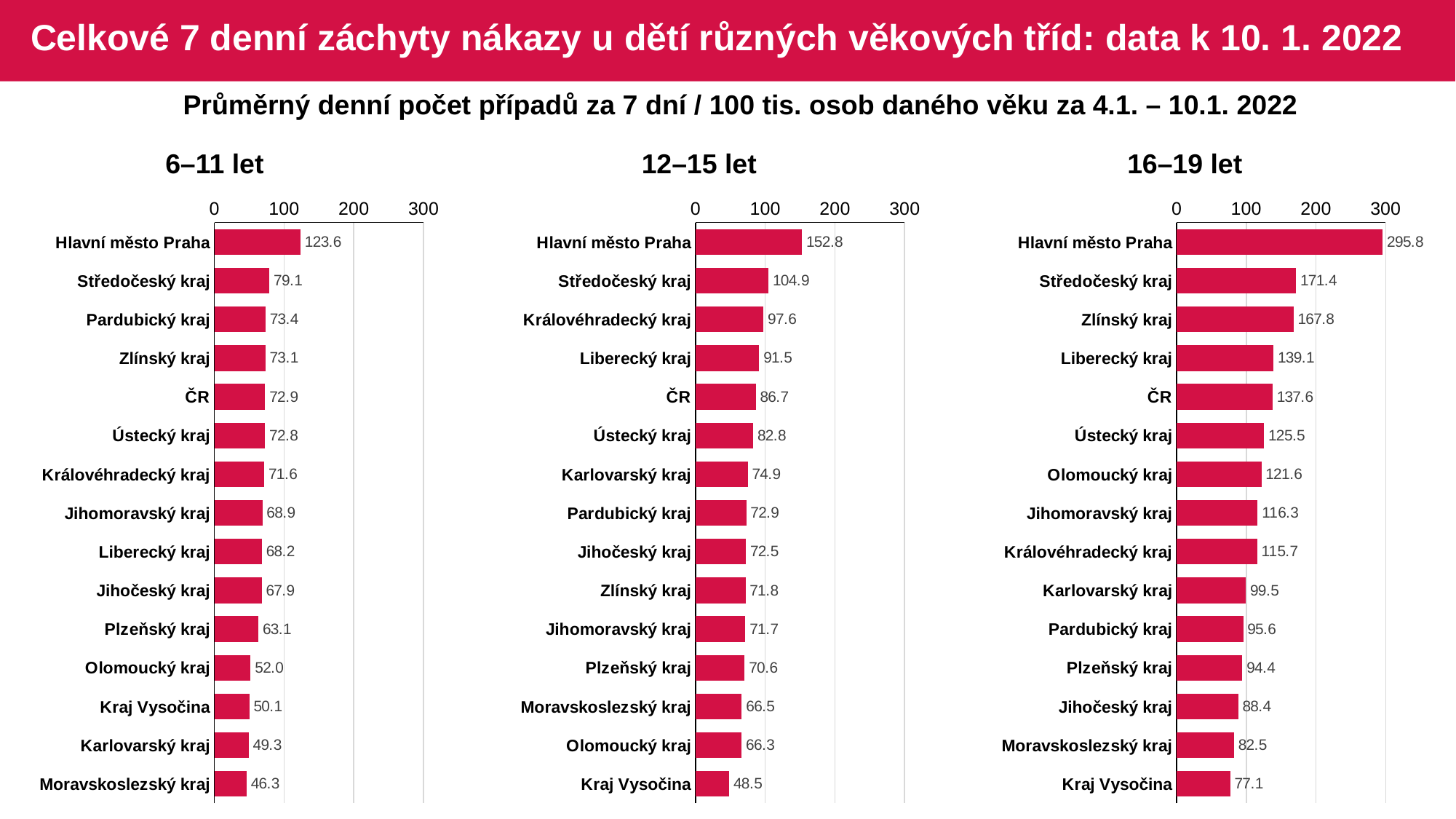
In the 6–11 let chart, which category has the lowest value? Moravskoslezský kraj In the 16–19 let chart, which is larger: the value for Olomoucký kraj or the value for Karlovarský kraj? Olomoucký kraj In the 12–15 let chart, which category has the lowest value? Kraj Vysočina In the 6–11 let chart, is the value for Hlavní město Praha greater or less than 100? greater In the 6–11 let chart, what is the value for Hlavní město Praha? 123.6 In the 16–19 let chart, what is the value for ČR? 137.6 What kind of chart is the 16–19 let chart? bar chart In the 16–19 let chart, what is the difference between the values for Hlavní město Praha and Středočeský kraj? 124.4 How many categories are shown in the 12–15 let chart? 15 In the 12–15 let chart, what is the difference between the values for Hlavní město Praha and Kraj Vysočina? 104.3 In the 16–19 let chart, which category has the highest value? Hlavní město Praha In the 12–15 let chart, what is the value for Liberecký kraj? 91.5